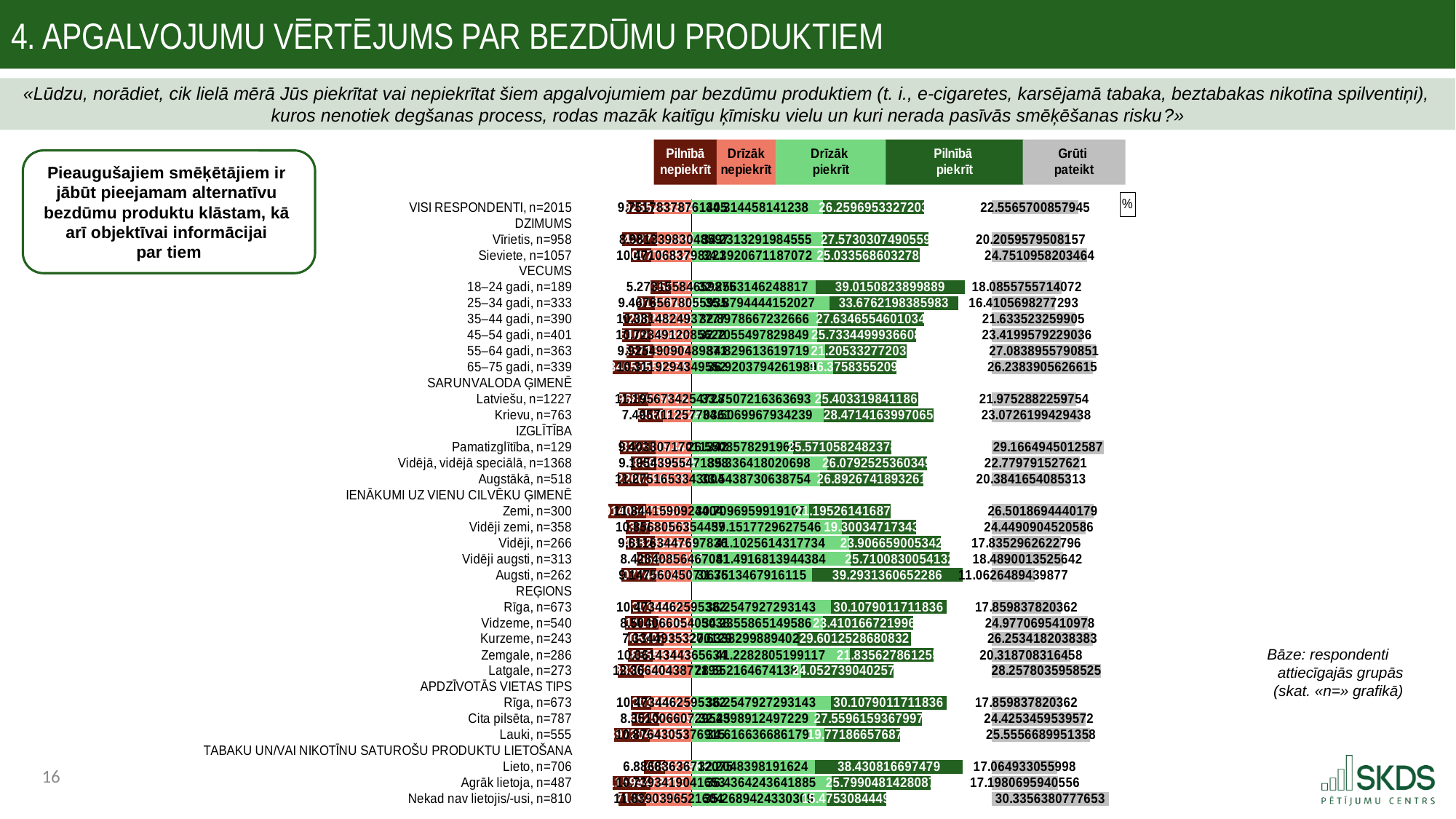
What kind of chart is shown on the slide? bar chart What is the 'Pilnībā piekrīt' value for Lieto, n=706? 38.430816697479 What is the 'Grūti pateikt' value for Augsti, n=262? 11.0626489439877 What is the 'Grūti pateikt' value for VISI RESPONDENTI, n=2015? 22.5565700857945 How many series does the legend list? 5 Which has the larger 'Pilnībā piekrīt' value: 18–24 gadi, n=189 or 25–34 gadi, n=333? 18–24 gadi, n=189 What is the 'Grūti pateikt' value for Nekad nav lietojis/-usi, n=810? 30.3356380777653 Which group has the highest 'Grūti pateikt' value? Nekad nav lietojis/-usi, n=810 What is the difference between the 'Grūti pateikt' values for Sieviete, n=1057 and Vīrietis, n=958? 4.5451378695307 Which group has the lowest 'Grūti pateikt' value? Augsti, n=262 What colour represents 'Grūti pateikt' in the legend? grey What is the 'Pilnībā piekrīt' value for 18–24 gadi, n=189? 39.0150823899889